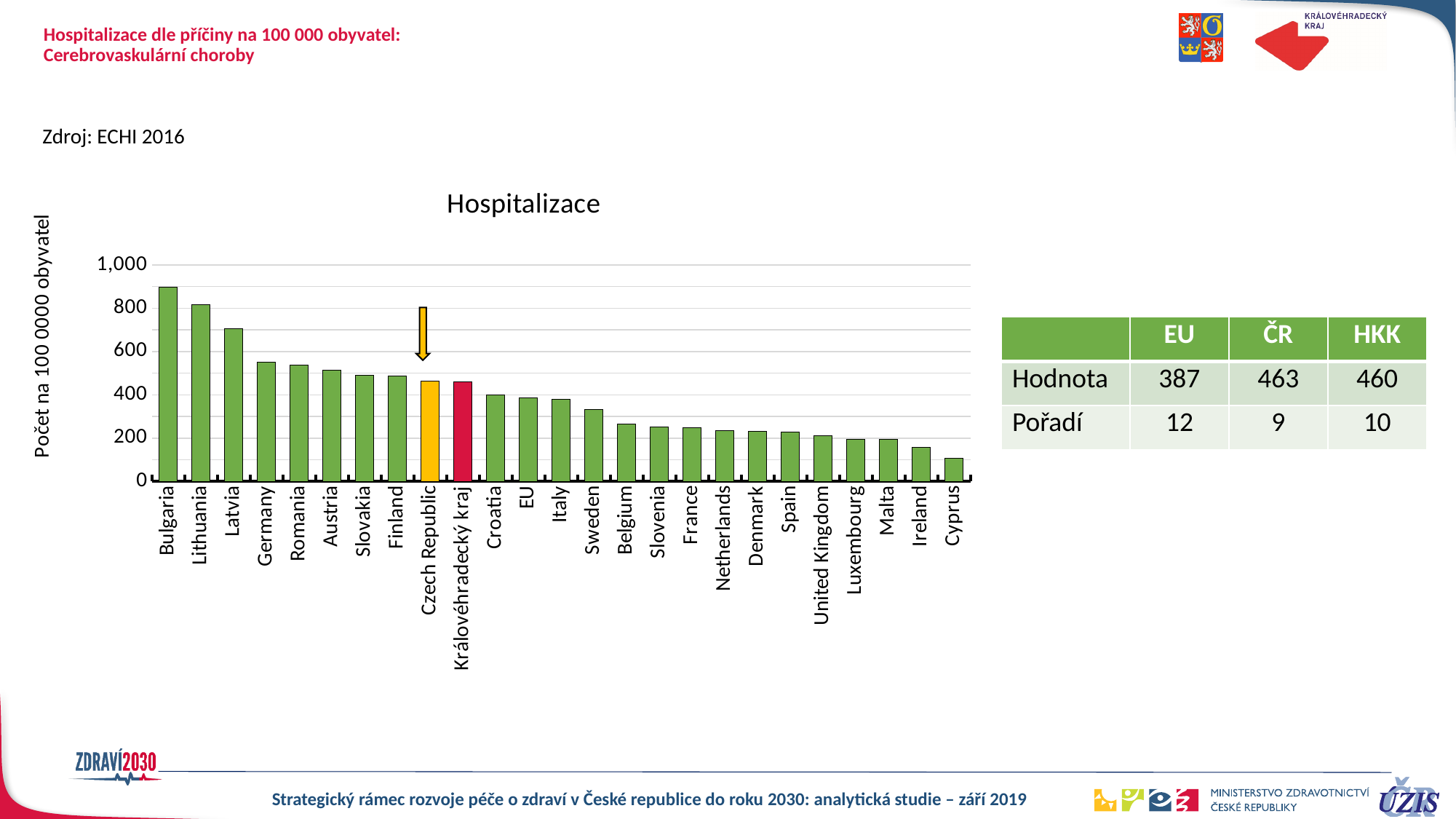
Which bar in the chart is coloured red? Královéhradecký kraj Is the value for Cyprus greater or less than 200? less What is the value for Královéhradecký kraj (HKK) according to the table next to the chart? 460 Which category has the lowest value in the "Hospitalizace" chart? Cyprus Which category has the highest value in the "Hospitalizace" chart? Bulgaria What is the value for the Czech Republic (ČR) according to the table next to the chart? 463 How many bars are plotted in the "Hospitalizace" chart? 25 What type of chart is shown under the title "Hospitalizace"? bar chart What is the value for the EU according to the table next to the chart? 387 Is the value for Bulgaria greater or less than 800? greater What is the difference between the value for ČR and the value for the EU shown in the table? 76 Do the bar values rise or fall from left to right along the x axis? fall